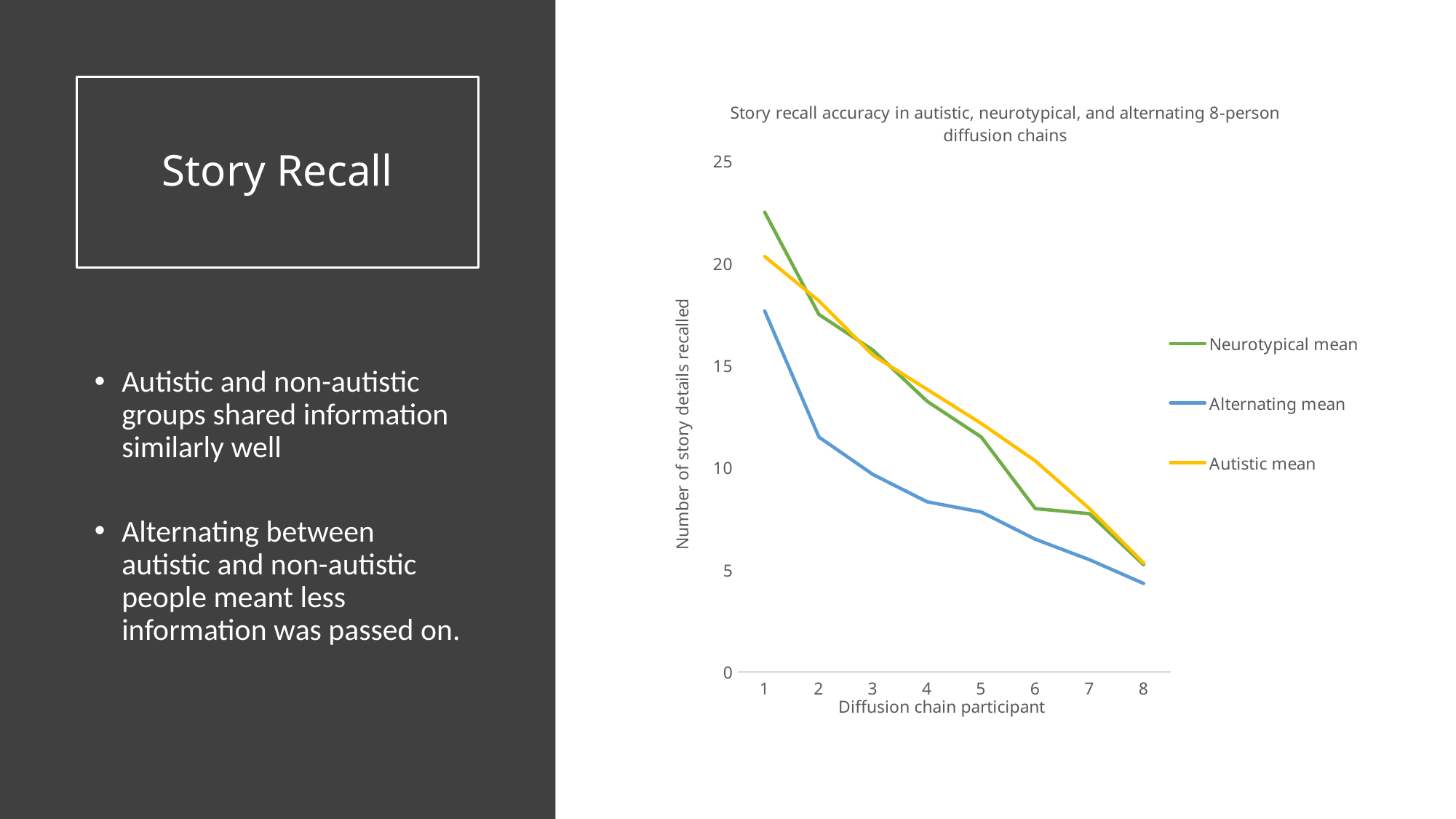
What kind of chart is shown on the slide? line chart What is the title of the chart? Story recall accuracy in autistic, neurotypical, and alternating 8-person diffusion chains Is the Alternating mean value at diffusion chain participant 4 greater or less than 10? less Is the Neurotypical mean value at diffusion chain participant 1 greater or less than 20? greater How many series does the legend list? 3 Do the values for the Alternating mean series rise or fall as the diffusion chain participant number increases? fall How many diffusion chain participants are plotted along the x axis? 8 What is the label of the vertical axis? Number of story details recalled At diffusion chain participant 6, which is larger: the Autistic mean or the Neurotypical mean? Autistic mean Which series has the highest value at diffusion chain participant 1? Neurotypical mean Which series has the lowest value at diffusion chain participant 8? Alternating mean Is the Autistic mean value at diffusion chain participant 5 greater or less than 10? greater